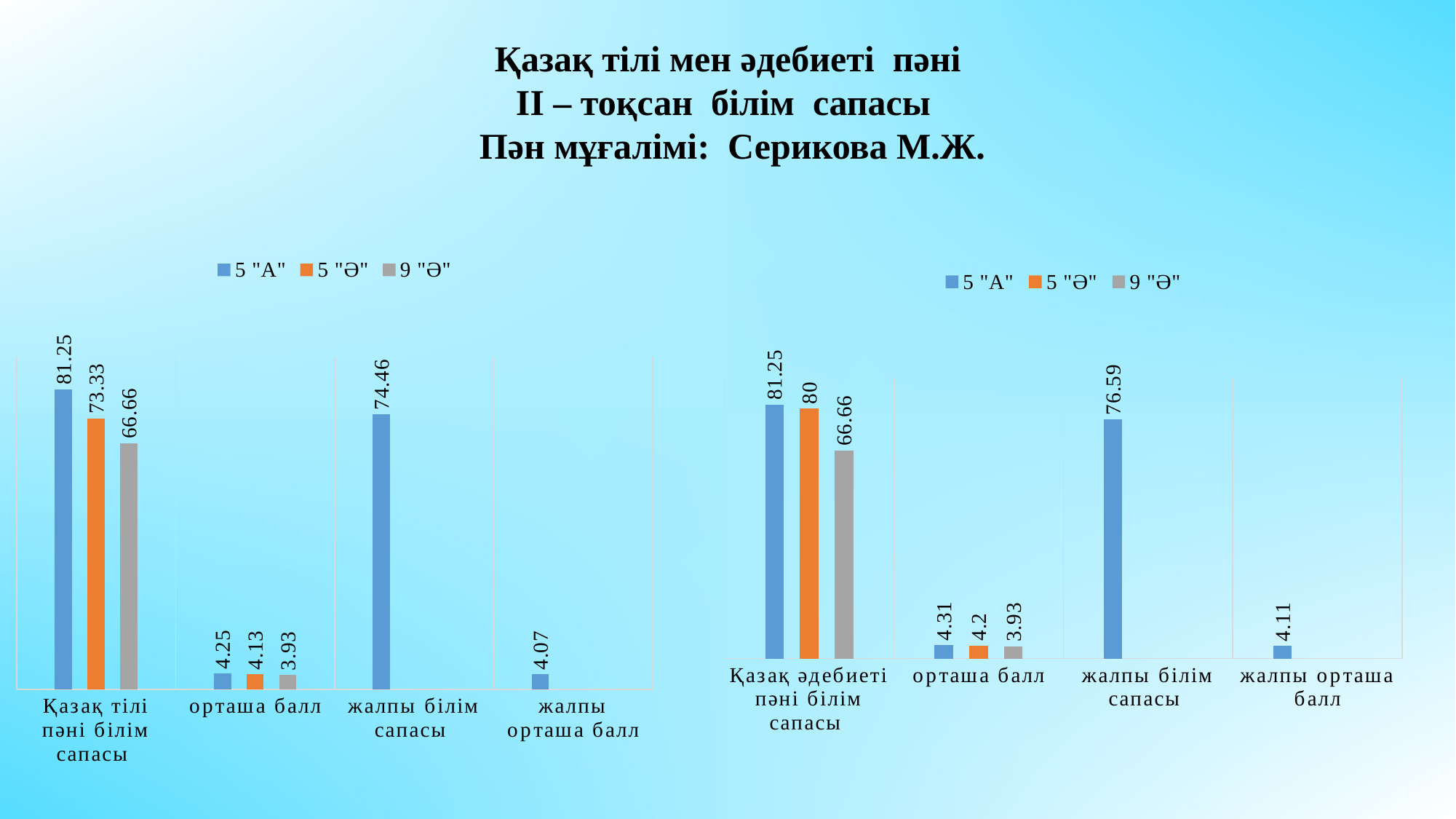
In the left chart, which series has the highest value in the category "Қазақ тілі пәні білім сапасы"? 5 "А" In the right chart, what is the value for 5 "Ә" in the category "Қазақ әдебиеті пәні білім сапасы"? 80 In the right chart, what is the difference between the 5 "А" and 5 "Ә" values in the category "Қазақ әдебиеті пәні білім сапасы"? 1.25 What type of chart is the right chart? bar chart In the right chart, what is the value shown for "жалпы орташа балл"? 4.11 In the left chart, what is the difference between the 5 "А" and 9 "Ә" values in the category "Қазақ тілі пәні білім сапасы"? 14.59 In the left chart, what is the value for 5 "Ә" in the category "Қазақ тілі пәні білім сапасы"? 73.33 In the right chart, which series has the lowest value in the category "орташа балл"? 9 "Ә" In the left chart, what is the value for 9 "Ә" in the category "орташа балл"? 3.93 How many series does the legend of the left chart list? 3 Which is larger: the "жалпы білім сапасы" value in the left chart or in the right chart? the right chart In the left chart, what is the value shown for "жалпы білім сапасы"? 74.46